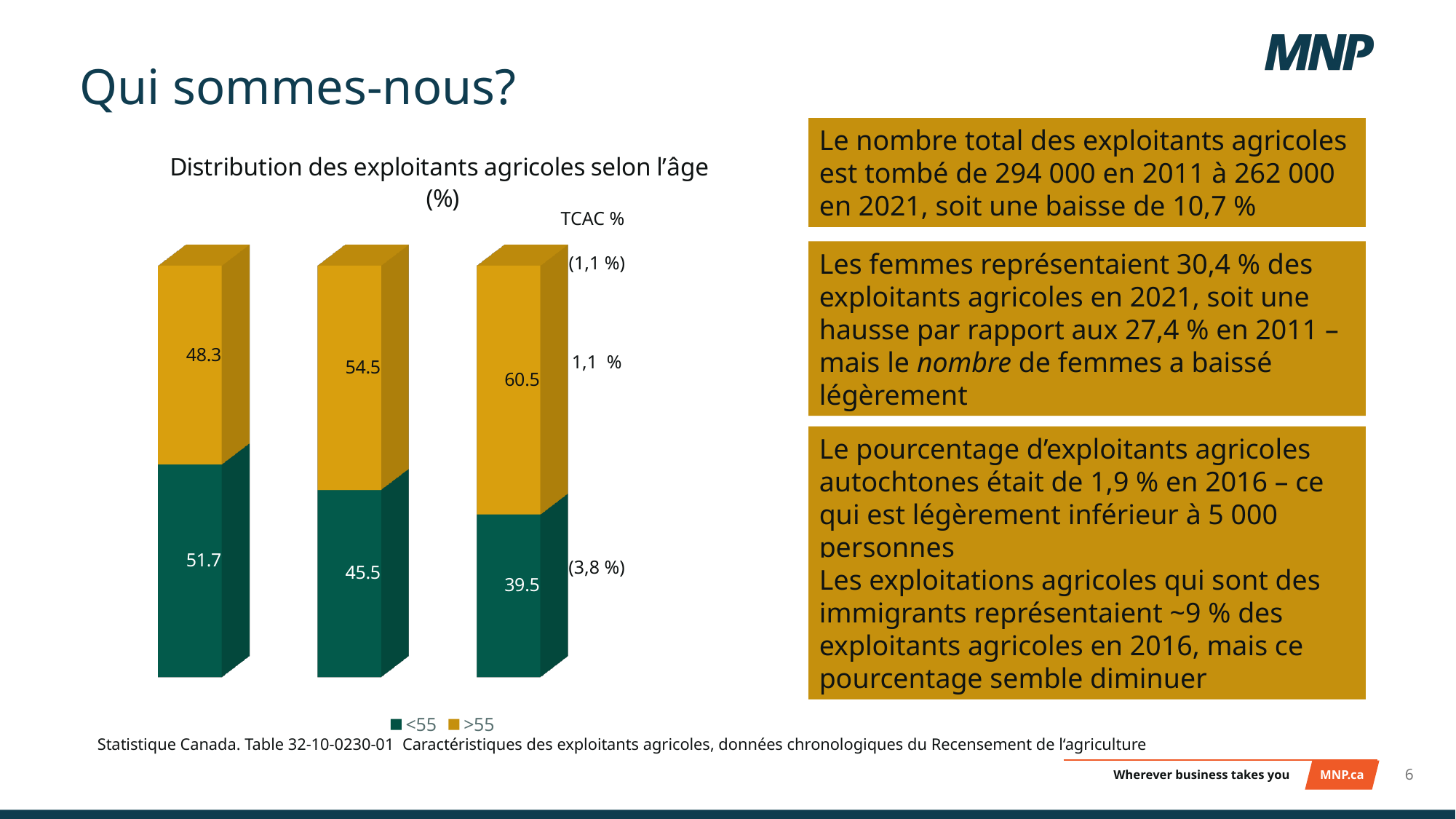
What is the difference between the >55 and <55 values in the rightmost bar? 21.0 What is the value of the >55 segment in the rightmost bar? 60.5 What is the total of the leftmost stacked bar? 100.0 What is the title of the chart? Distribution des exploitants agricoles selon l'âge (%) What is the value of the >55 segment in the middle bar? 54.5 What kind of chart is shown on the slide? Stacked bar chart Do the <55 values rise or fall from the leftmost bar to the rightmost bar? Fall What is the value of the <55 segment in the leftmost bar? 51.7 How many series does the chart legend list? 2 Which bar has the highest >55 value? The rightmost bar Which bar has the lowest <55 value? The rightmost bar How many bars are plotted in the chart? 3